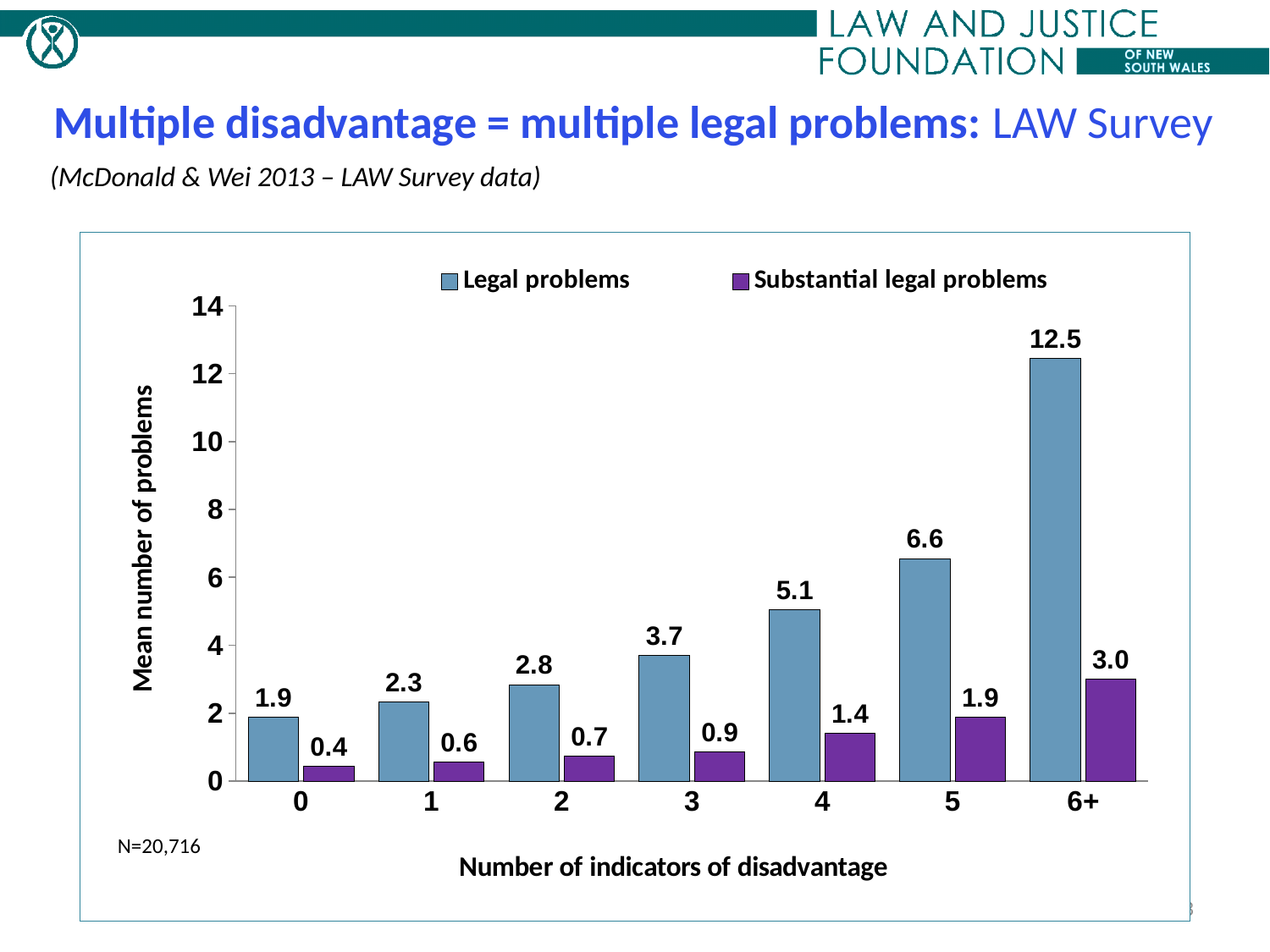
Which number of indicators of disadvantage has the lowest mean number of substantial legal problems? 0 What kind of chart is shown on the slide? Bar chart Does the mean number of legal problems rise or fall as the number of indicators of disadvantage increases? Rises What is the mean number of legal problems for people with 6+ indicators of disadvantage? 12.5 How many series does the legend list? 2 How many categories of number of indicators of disadvantage are shown on the x axis? 7 What is the mean number of legal problems for people with 0 indicators of disadvantage? 1.9 Which is larger: the mean number of legal problems at 4 indicators or at 2 indicators of disadvantage? 4 indicators Which number of indicators of disadvantage has the highest mean number of legal problems? 6+ What is the difference between the mean number of legal problems and substantial legal problems for people with 5 indicators of disadvantage? 4.7 What is the mean number of substantial legal problems for people with 3 indicators of disadvantage? 0.9 Is the mean number of legal problems for 6+ indicators of disadvantage greater or less than 12? greater